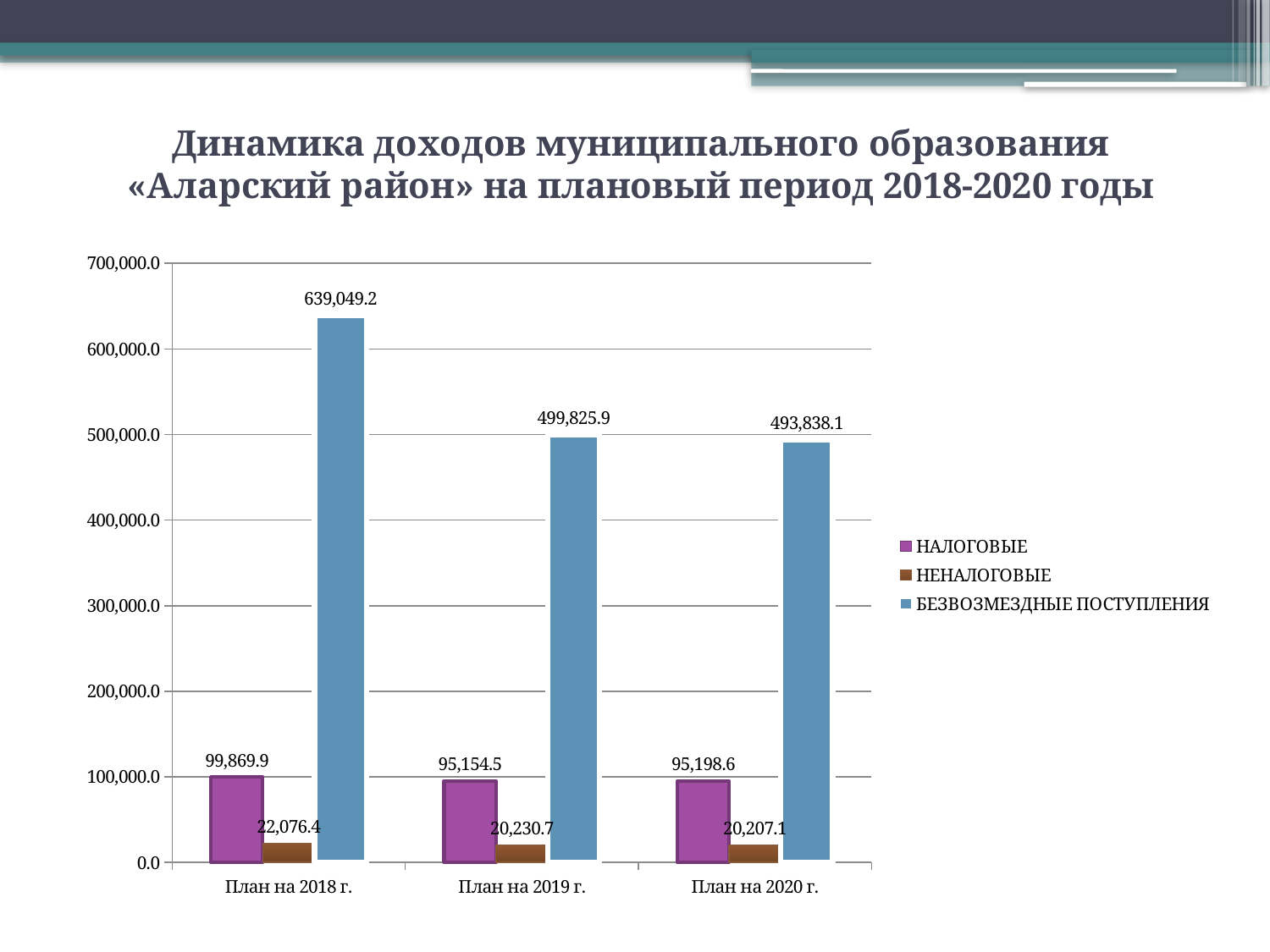
Does the value of БЕЗВОЗМЕЗДНЫЕ ПОСТУПЛЕНИЯ rise or fall from План на 2018 г. to План на 2020 г.? fall How many categories are shown on the x axis? 3 What is the value of НАЛОГОВЫЕ for План на 2019 г.? 95,154.5 Which series has the lowest value for План на 2018 г.? НЕНАЛОГОВЫЕ How many series does the legend list? 3 In which year is the value of БЕЗВОЗМЕЗДНЫЕ ПОСТУПЛЕНИЯ highest? План на 2018 г. What is the difference between НАЛОГОВЫЕ for План на 2018 г. and План на 2019 г.? 4,715.4 What is the difference between БЕЗВОЗМЕЗДНЫЕ ПОСТУПЛЕНИЯ for План на 2018 г. and План на 2019 г.? 139,223.3 What is the value of БЕЗВОЗМЕЗДНЫЕ ПОСТУПЛЕНИЯ for План на 2018 г.? 639,049.2 Is the value of БЕЗВОЗМЕЗДНЫЕ ПОСТУПЛЕНИЯ for План на 2018 г. greater or less than 600,000.0? greater What is the value of НЕНАЛОГОВЫЕ for План на 2020 г.? 20,207.1 Which is larger: НЕНАЛОГОВЫЕ for План на 2018 г. or for План на 2019 г.? План на 2018 г.